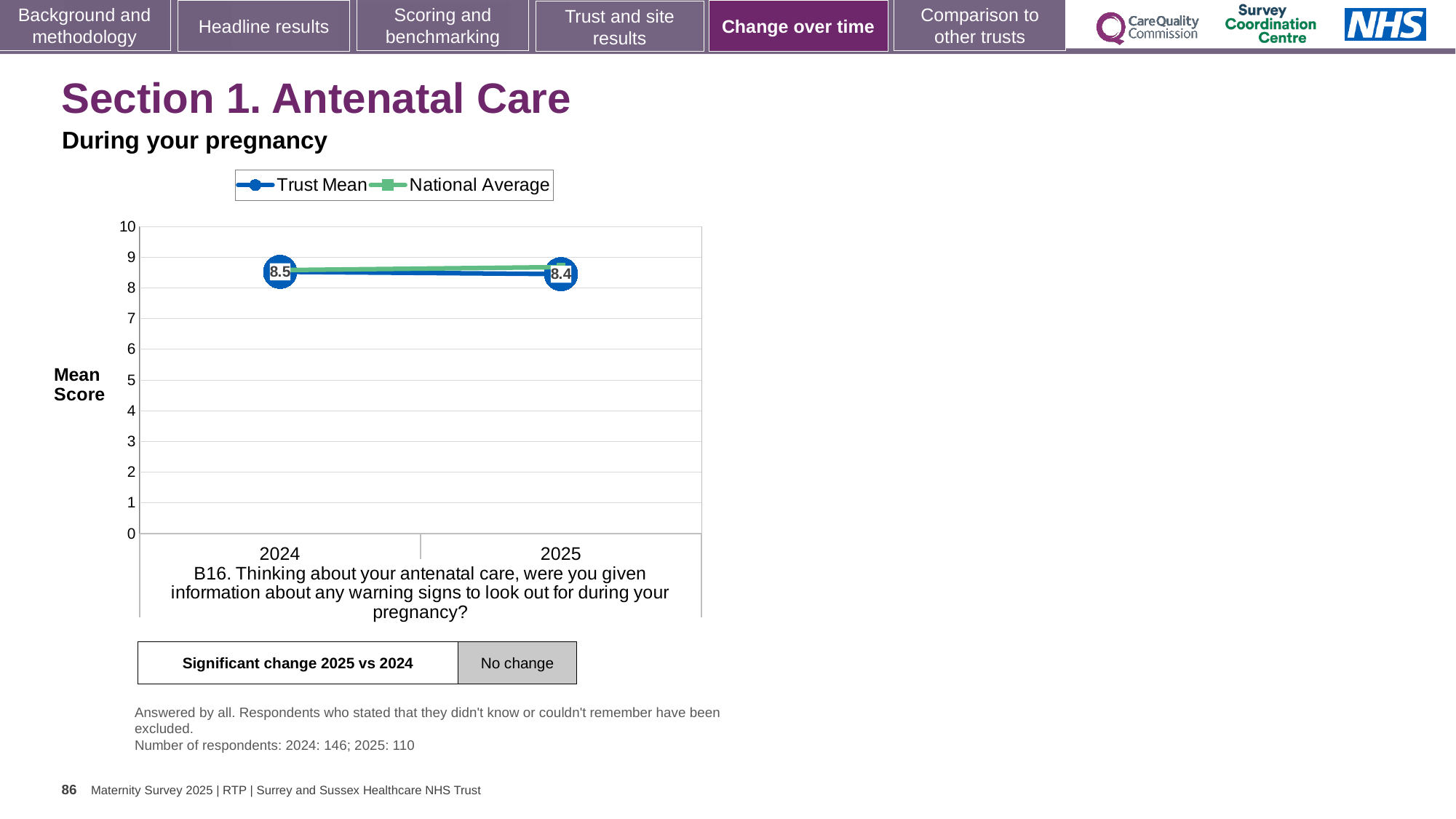
Does the Trust Mean rise or fall from 2024 to 2025? fall Which year has the higher Trust Mean, 2024 or 2025? 2024 What is the Trust Mean value for 2025? 8.4 How many series does the chart legend list? 2 What is the label on the y axis of the chart? Mean Score Is the National Average value for 2025 greater or less than 8? greater How many years are shown on the x axis of the chart? 2 What is the Trust Mean value for 2024? 8.5 What are the two series named in the chart legend? Trust Mean and National Average What kind of chart is shown on the slide? line chart By how much did the Trust Mean change from 2024 to 2025? 0.1 Is the Trust Mean value for 2024 greater or less than 9? less